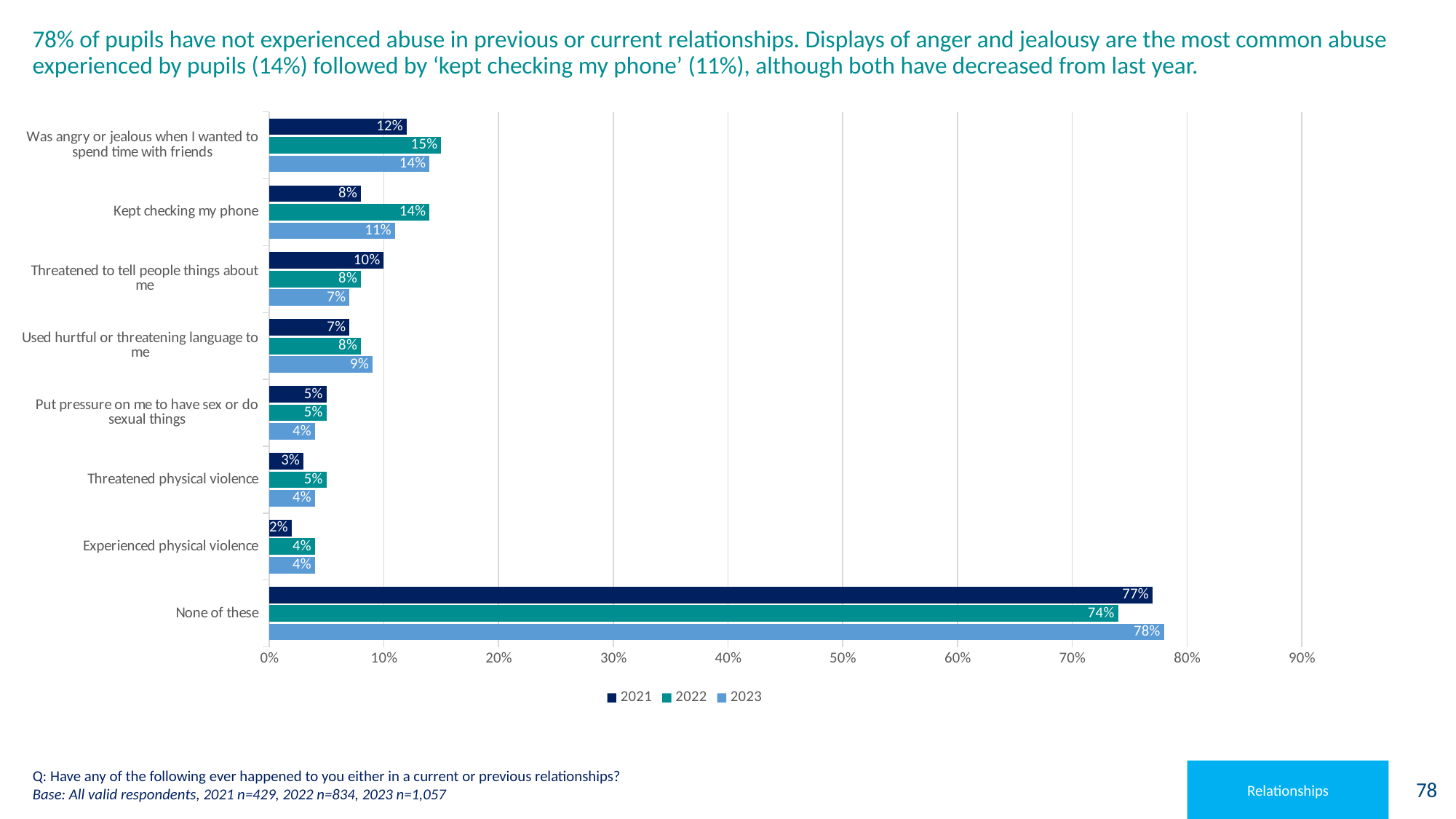
Which is larger for 'Used hurtful or threatening language to me': the 2021 value or the 2023 value? 2023 Which category has the highest 2023 value? None of these How many series does the legend list? 3 Which series is shown in the darkest blue colour? 2021 What is the 2022 value for 'None of these'? 74% What is the 2021 value for 'Was angry or jealous when I wanted to spend time with friends'? 12% What is the 2023 value for 'Kept checking my phone'? 11% What is the difference between the 2022 and 2023 values for 'Kept checking my phone'? 3% How many categories are shown on the chart? 8 Which category has the lowest 2021 value? Experienced physical violence Is the 2023 value for 'None of these' greater or less than 70%? greater What kind of chart is shown on the slide? Bar chart